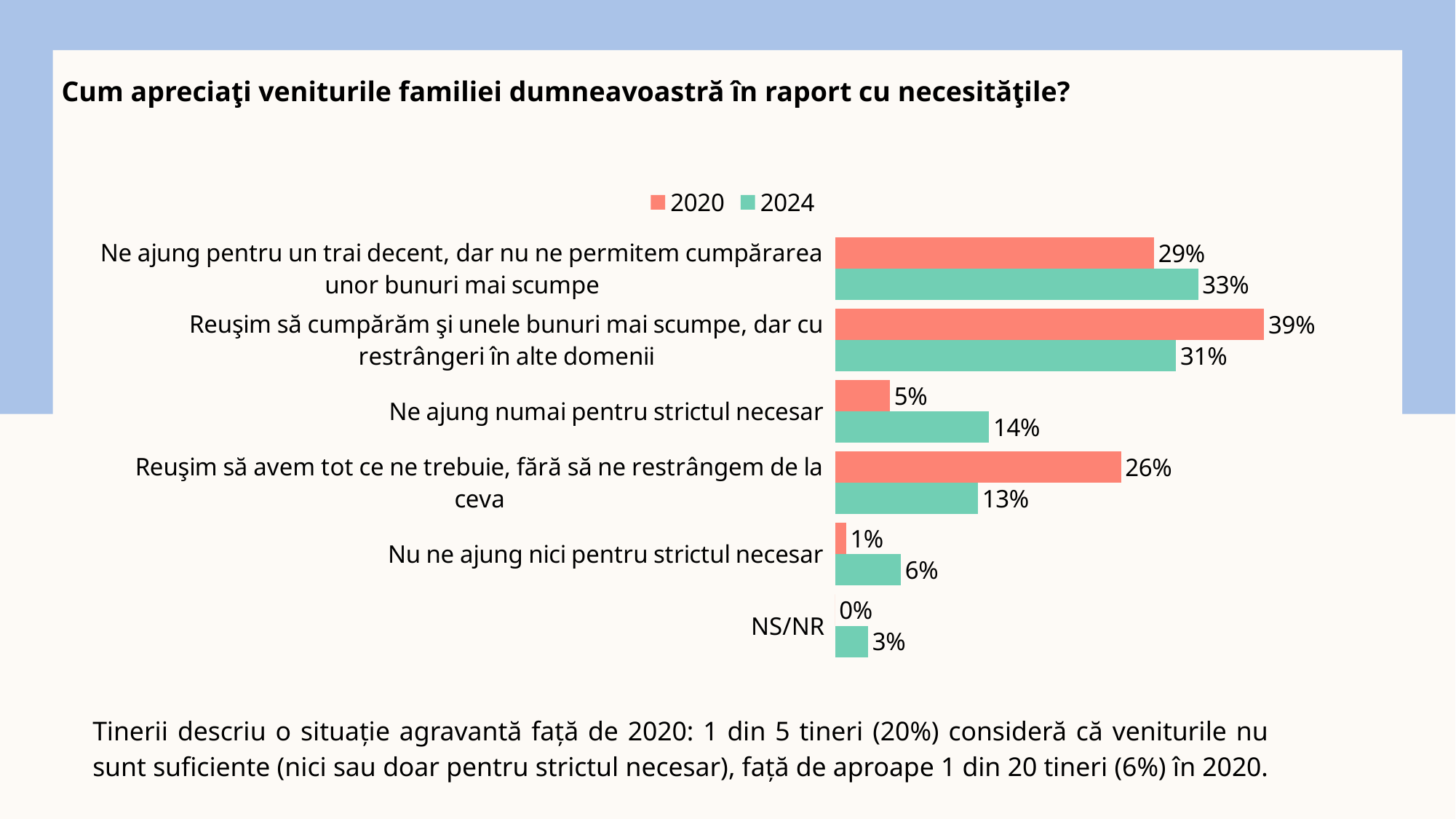
Which category has the lowest 2024 value? NS/NR How many series does the legend list? 2 Which category has the highest 2020 value? Reuşim să cumpărăm şi unele bunuri mai scumpe, dar cu restrângeri în alte domenii What is the difference between the 2020 and 2024 values for "Reuşim să avem tot ce ne trebuie, fără să ne restrângem de la ceva"? 13% What is the 2024 value for "NS/NR"? 3% Which colour represents the 2024 series in the chart? Green What kind of chart is shown on the slide? Bar chart What is the 2024 value for "Ne ajung numai pentru strictul necesar"? 14% How many categories are shown in the chart? 6 Which is larger for "Ne ajung pentru un trai decent, dar nu ne permitem cumpărarea unor bunuri mai scumpe": the 2020 value or the 2024 value? 2024 What is the difference between the 2024 and 2020 values for "Nu ne ajung nici pentru strictul necesar"? 5% What is the 2020 value for "Reuşim să cumpărăm şi unele bunuri mai scumpe, dar cu restrângeri în alte domenii"? 39%